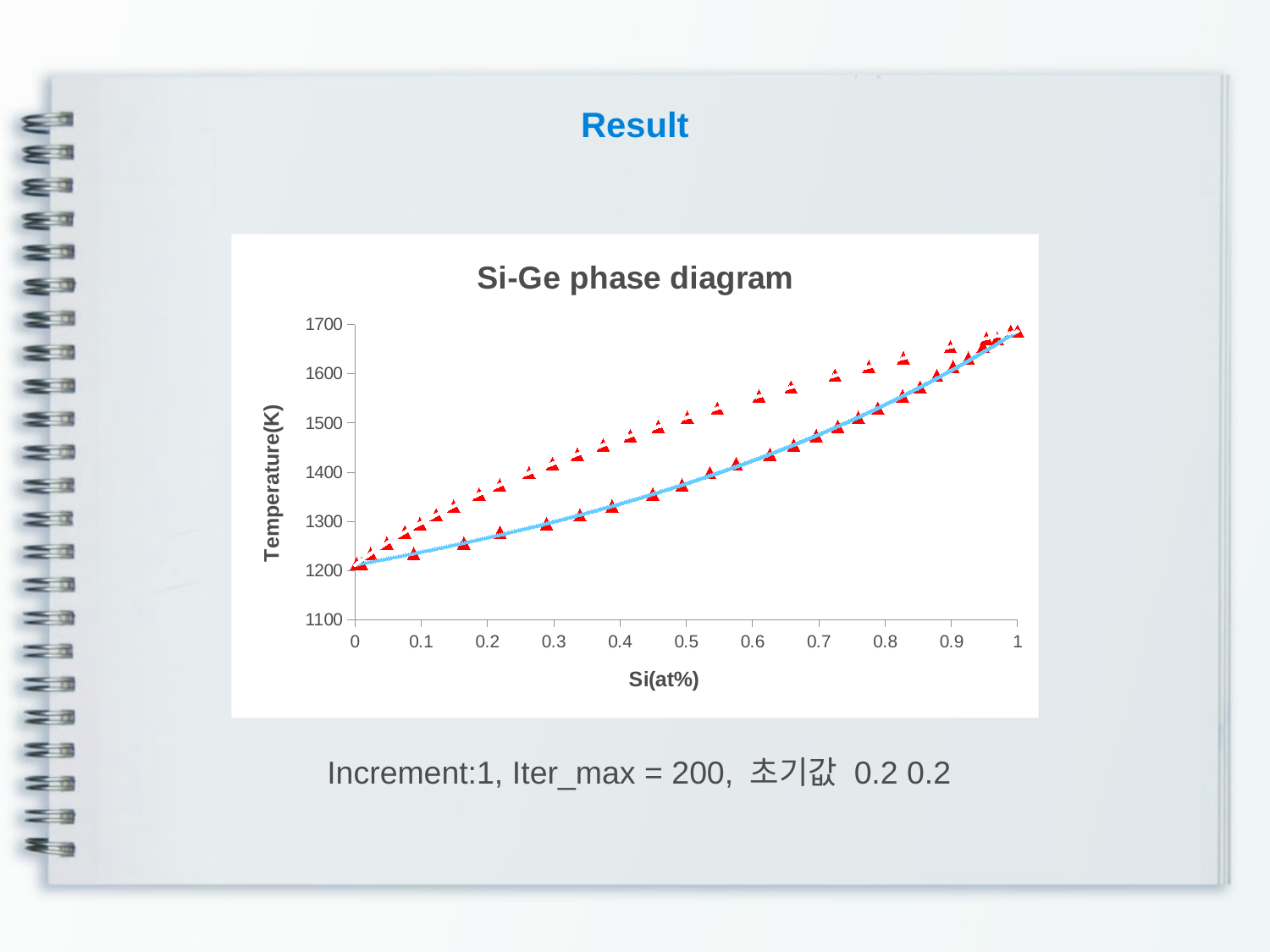
Which has the higher temperature at Si(at%) = 0.3, the upper curve or the lower curve? the upper curve Is the temperature at Si(at%) = 1 greater or less than 1600? greater Is the temperature of the lower curve at Si(at%) = 0.5 greater or less than 1300? greater What kind of chart is the Si-Ge phase diagram? scatter chart Do the plotted temperatures rise or fall as Si(at%) increases from 0 to 1? rise Is the temperature of the lower curve at Si(at%) = 0.2 greater or less than 1300? greater What is the label of the vertical axis? Temperature(K) What is the highest value shown on the Temperature(K) axis? 1700 What is the title of the chart? Si-Ge phase diagram